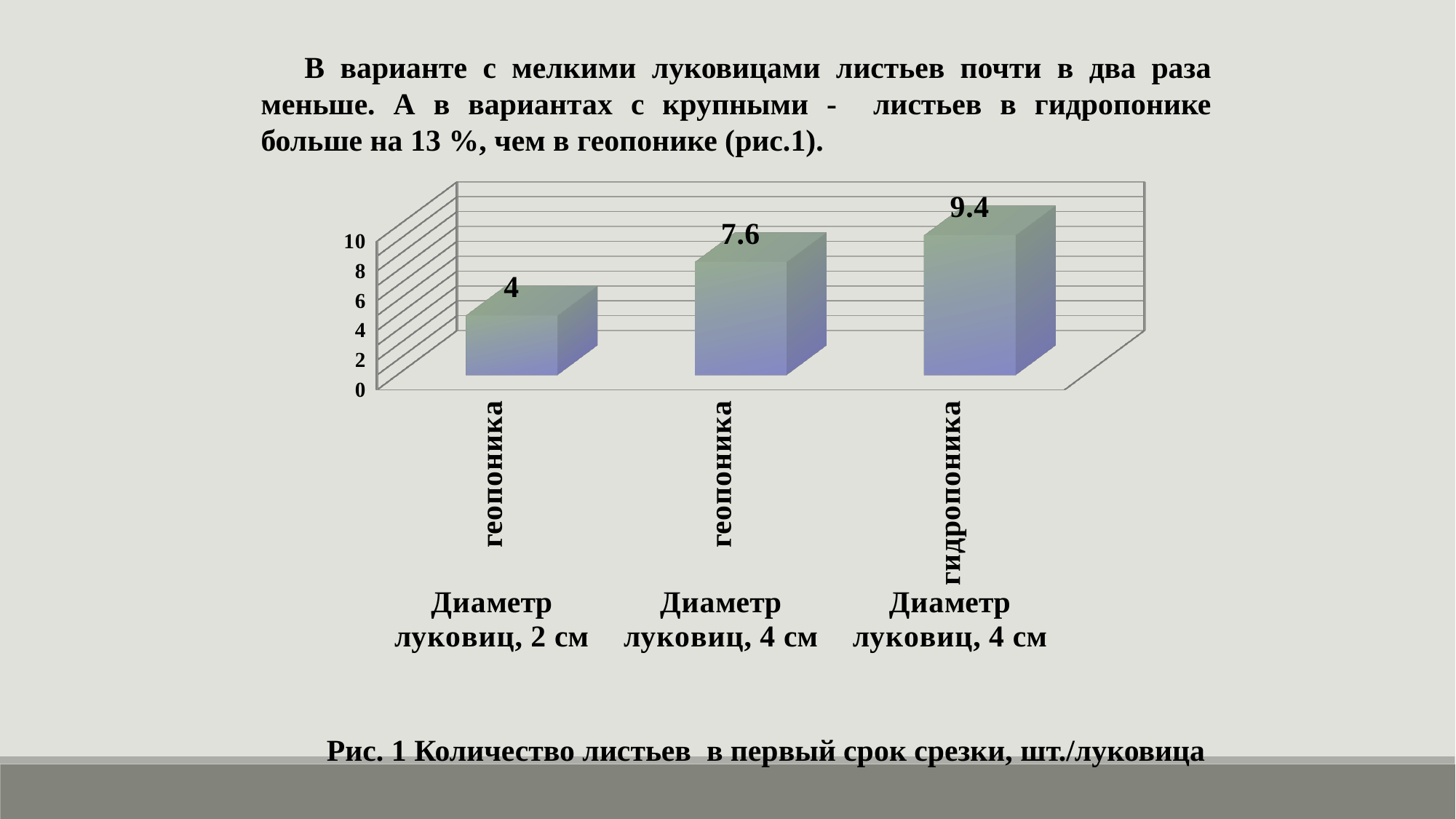
What is the difference between the гидропоника (4 см) value and the геопоника (4 см) value? 1.8 Which bar has the highest value? гидропоника, Диаметр луковиц, 4 см Which is larger: the value for геопоника at 4 см or for гидропоника at 4 см? гидропоника at 4 см What is the difference between the геопоника 4 см value and the геопоника 2 см value? 3.6 What is the number of leaves for геопоника with bulb diameter 2 см? 4 What is the caption of the figure below the chart? Рис. 1 Количество листьев в первый срок срезки, шт./луковица Is the value for гидропоника (4 см) greater or less than 8? greater Which bar has the lowest value? геопоника, Диаметр луковиц, 2 см What type of chart is shown on the slide? bar chart What is the number of leaves for геопоника with bulb diameter 4 см? 7.6 How many bars are shown in the chart? 3 What is the number of leaves for гидропоника with bulb diameter 4 см? 9.4